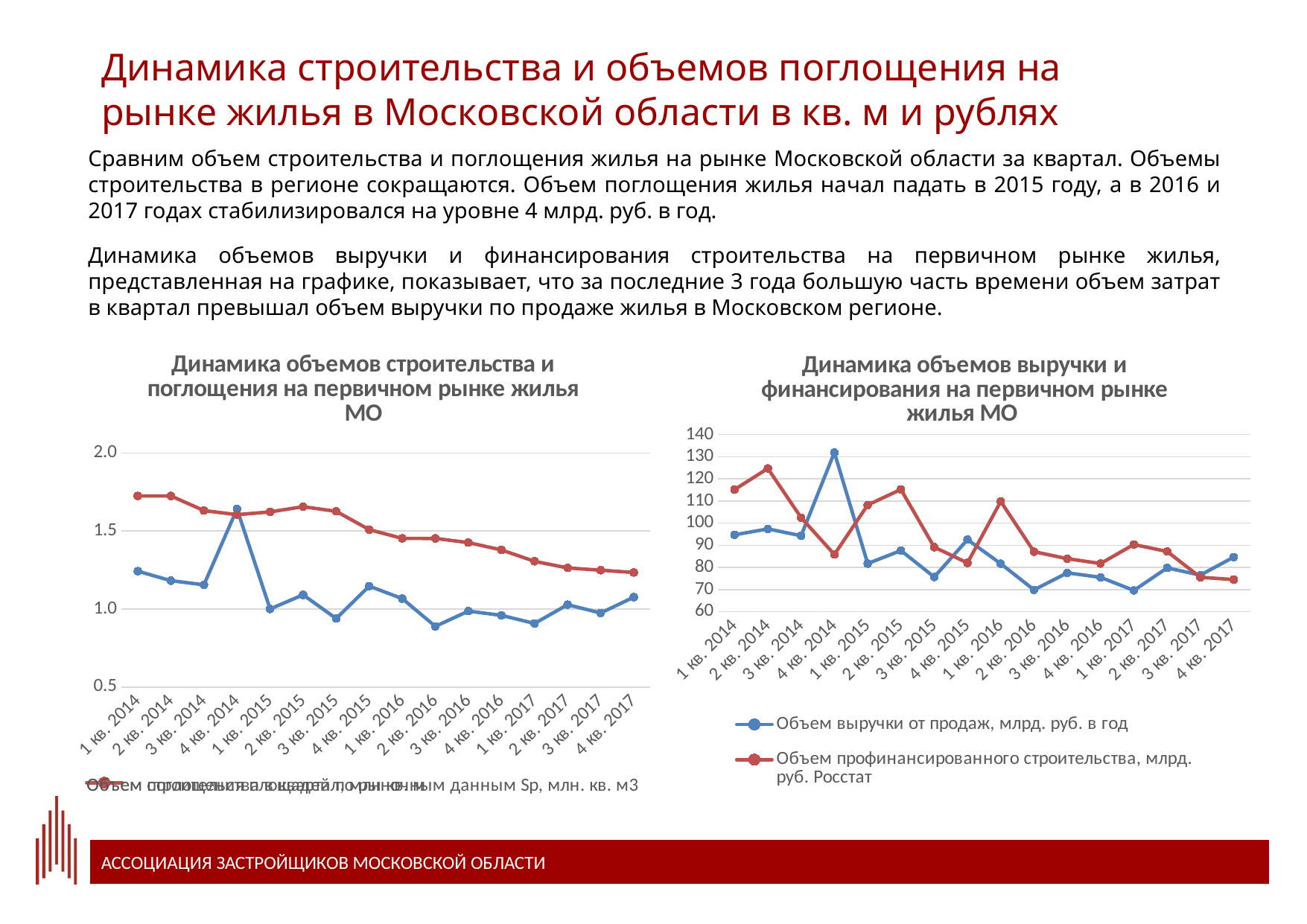
In the right-hand chart, in which quarter does "Объем выручки от продаж, млрд. руб. в год" reach its highest value? 4 кв. 2014 What kind of chart is the chart titled "Динамика объемов выручки и финансирования на первичном рынке жилья МО"? line chart How many quarters are shown on the x axis of the left-hand chart ("Динамика объемов строительства и поглощения...")? 16 In the right-hand chart, is the value of "Объем профинансированного строительства" in 1 кв. 2016 greater or less than 100? greater How many series does the legend of the right-hand chart ("Динамика объемов выручки и финансирования...") list? 2 In the left-hand chart, in which quarter does the blue series reach its highest value? 4 кв. 2014 In the right-hand chart, in which quarter does "Объем профинансированного строительства, млрд. руб. Росстат" reach its highest value? 2 кв. 2014 In the left-hand chart, does the red series rise or fall overall from 1 кв. 2014 to 4 кв. 2017? fall In the right-hand chart, is the value of "Объем выручки от продаж" in 4 кв. 2014 greater or less than 120? greater In the left-hand chart, is the value of the red series in 1 кв. 2014 greater or less than 1.5? greater In the right-hand chart, which series has the larger value in 4 кв. 2014: "Объем выручки от продаж" or "Объем профинансированного строительства"? Объем выручки от продаж